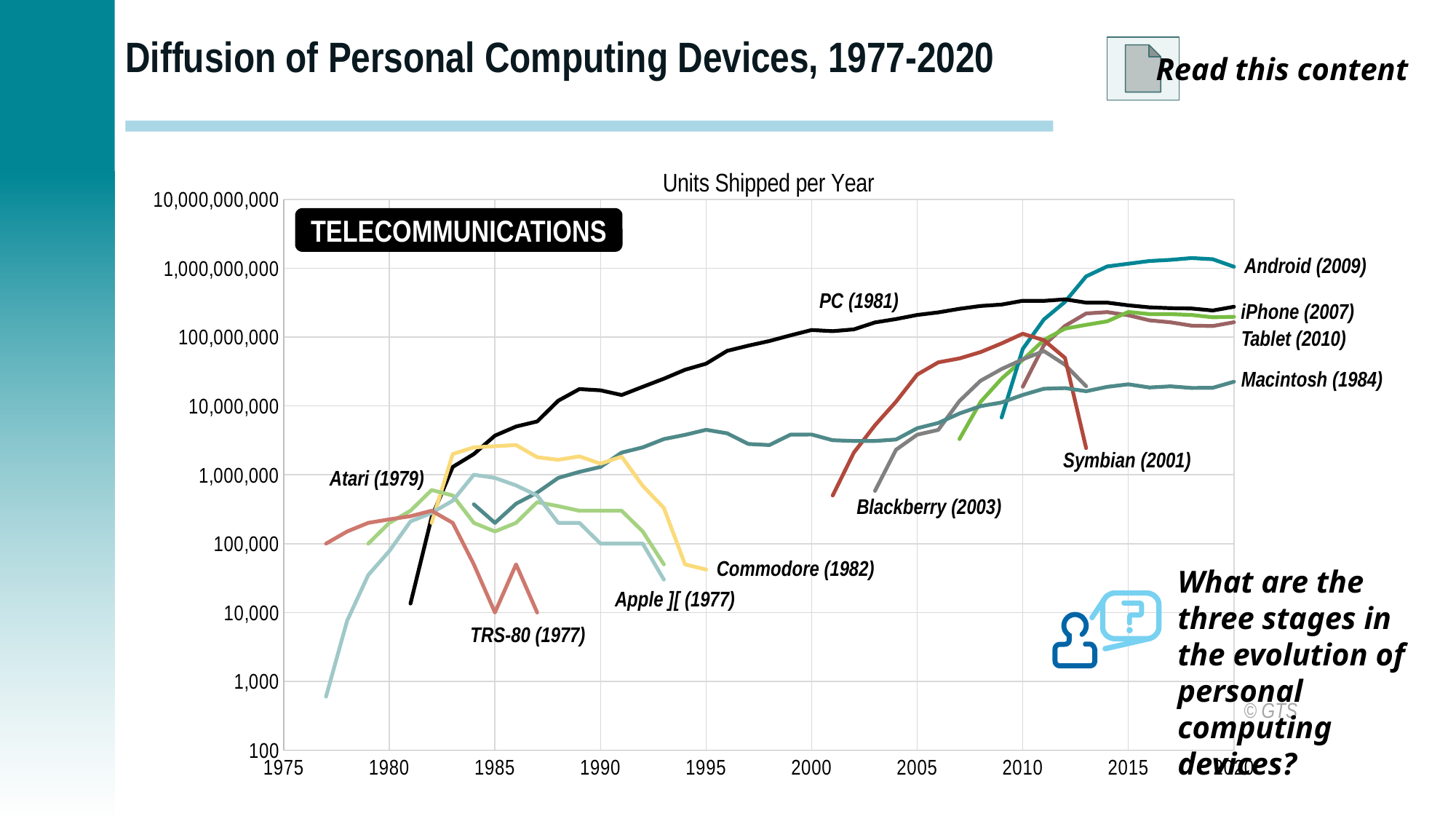
In 2020, which is larger: the value for Android (2009) or the value for PC (1981)? Android (2009) What is the title printed above the chart's plot area? Units Shipped per Year Does the PC (1981) line rise or fall between 1981 and 2010? Rise Is the peak value for Android (2009) greater or less than 1,000,000,000? greater Is the value for PC (1981) in 2020 greater or less than 1,000,000,000? less Is the peak value for Blackberry (2003) greater or less than 100,000,000? less What kind of chart is shown on the slide? Line chart Which device series reaches the highest value on the chart? Android (2009) How many labelled device series are plotted on the chart? 11 Does the Symbian (2001) line rise or fall after 2010? Fall